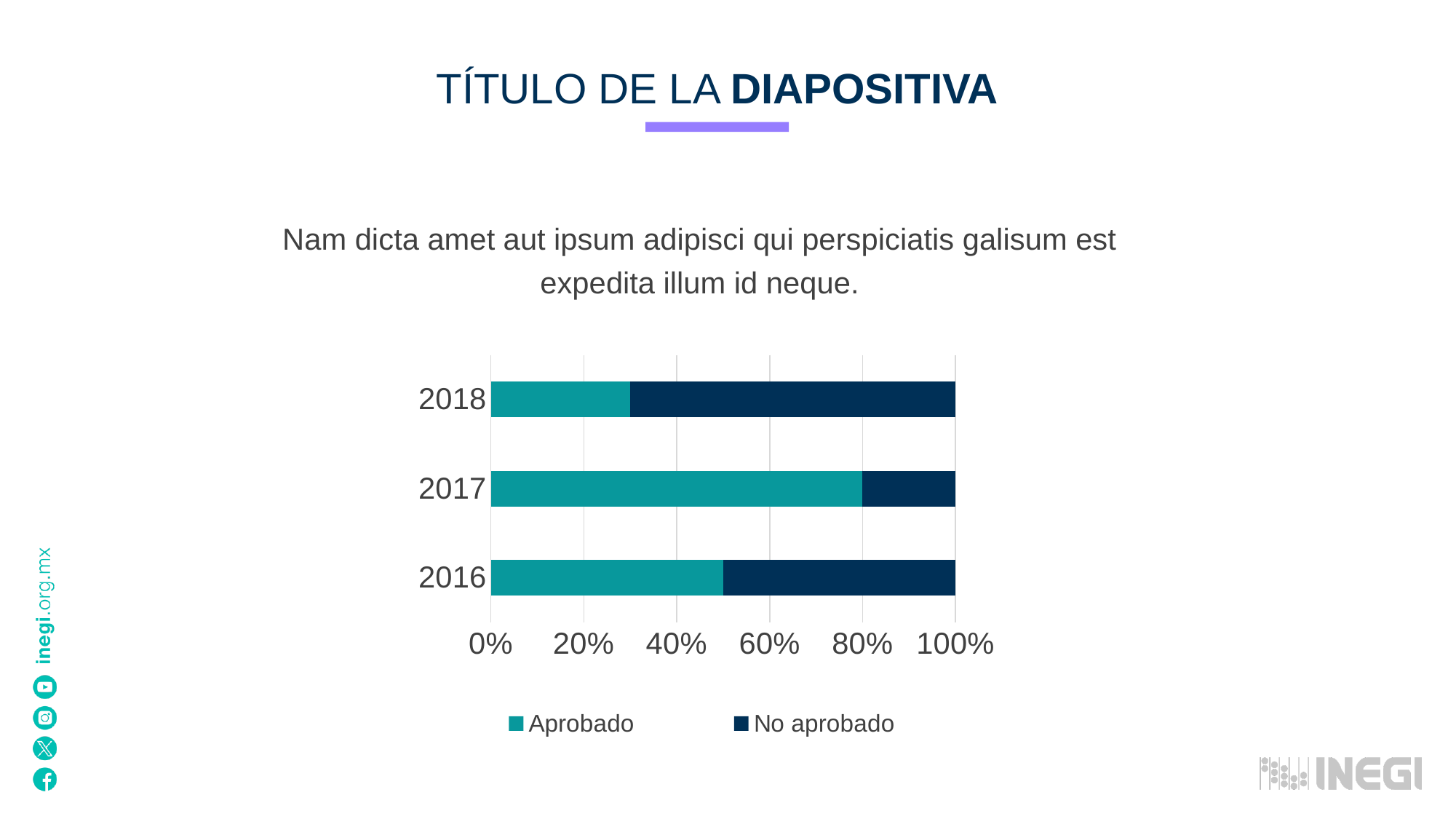
Is the Aprobado share for 2016 greater or less than 40%? greater What kind of chart is shown on the slide? bar chart Which year has the largest No aprobado share? 2018 How many years are shown on the chart? 3 Which year has the larger Aprobado share, 2016 or 2018? 2016 How many series does the legend list? 2 Is the Aprobado share for 2016 greater or less than 60%? less What are the two series named in the legend? Aprobado and No aprobado Which year has the lowest Aprobado share? 2018 Which year has the highest Aprobado share? 2017 What is the Aprobado share for 2017? 80% Is the Aprobado share for 2018 greater or less than 40%? less